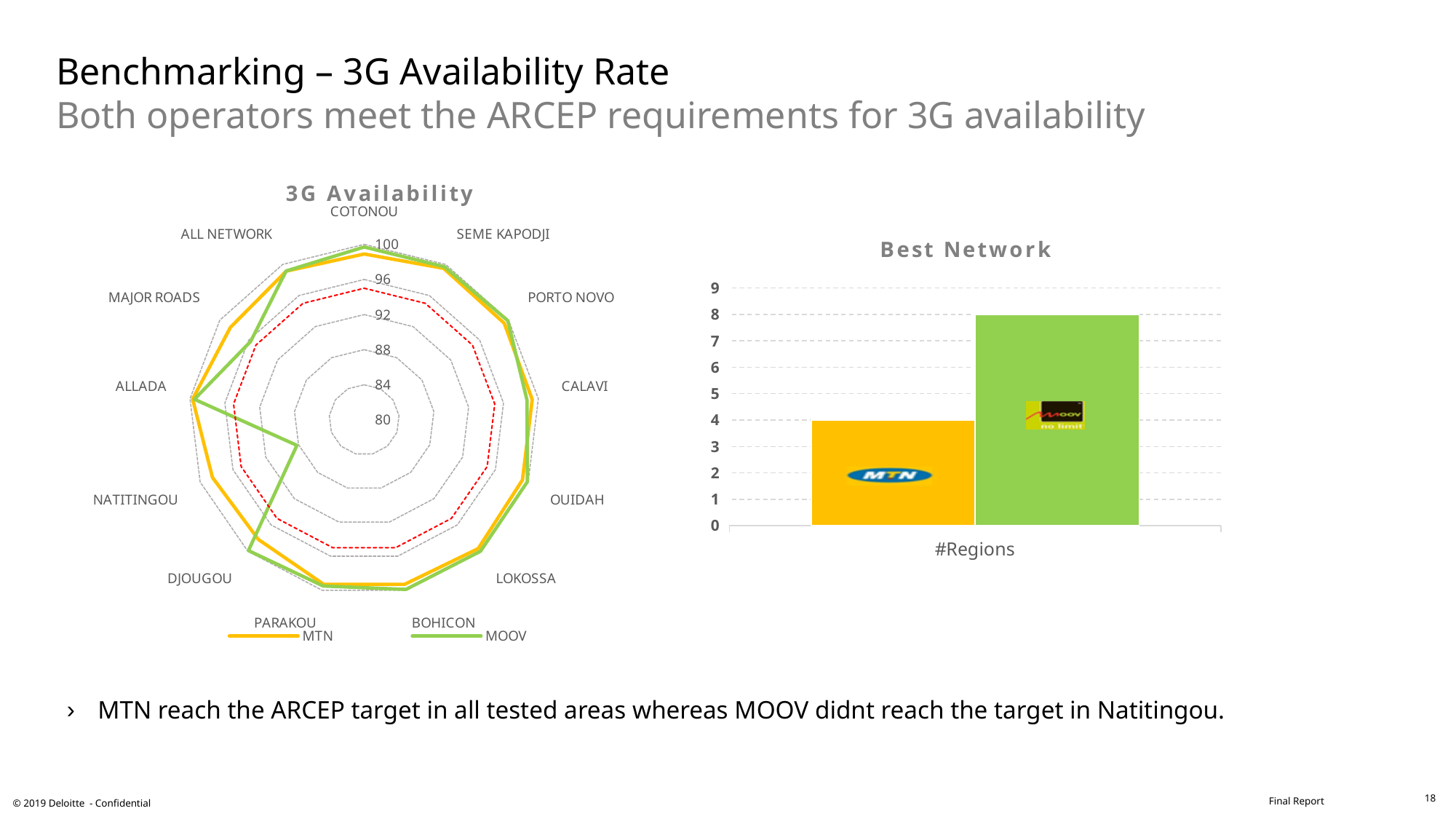
What kind of chart is the 3G Availability chart? radar chart In the 3G Availability chart, is the MOOV value for NATITINGOU greater or less than 92? less In the 3G Availability chart, which operator has the lower value at NATITINGOU? MOOV In the 3G Availability chart, is the MTN value for NATITINGOU greater or less than 96? greater In the Best Network chart, what is the value for MTN? 4 What kind of chart is the Best Network chart? bar chart In the Best Network chart, which operator has the higher number of regions? MOOV In the Best Network chart, what is the value for MOOV? 8 How many categories are plotted on the 3G Availability radar chart? 13 How many series does the legend of the 3G Availability chart list? 2 In the 3G Availability chart, which colour represents MTN? yellow In the Best Network chart, what is the difference between the MOOV and MTN values? 4